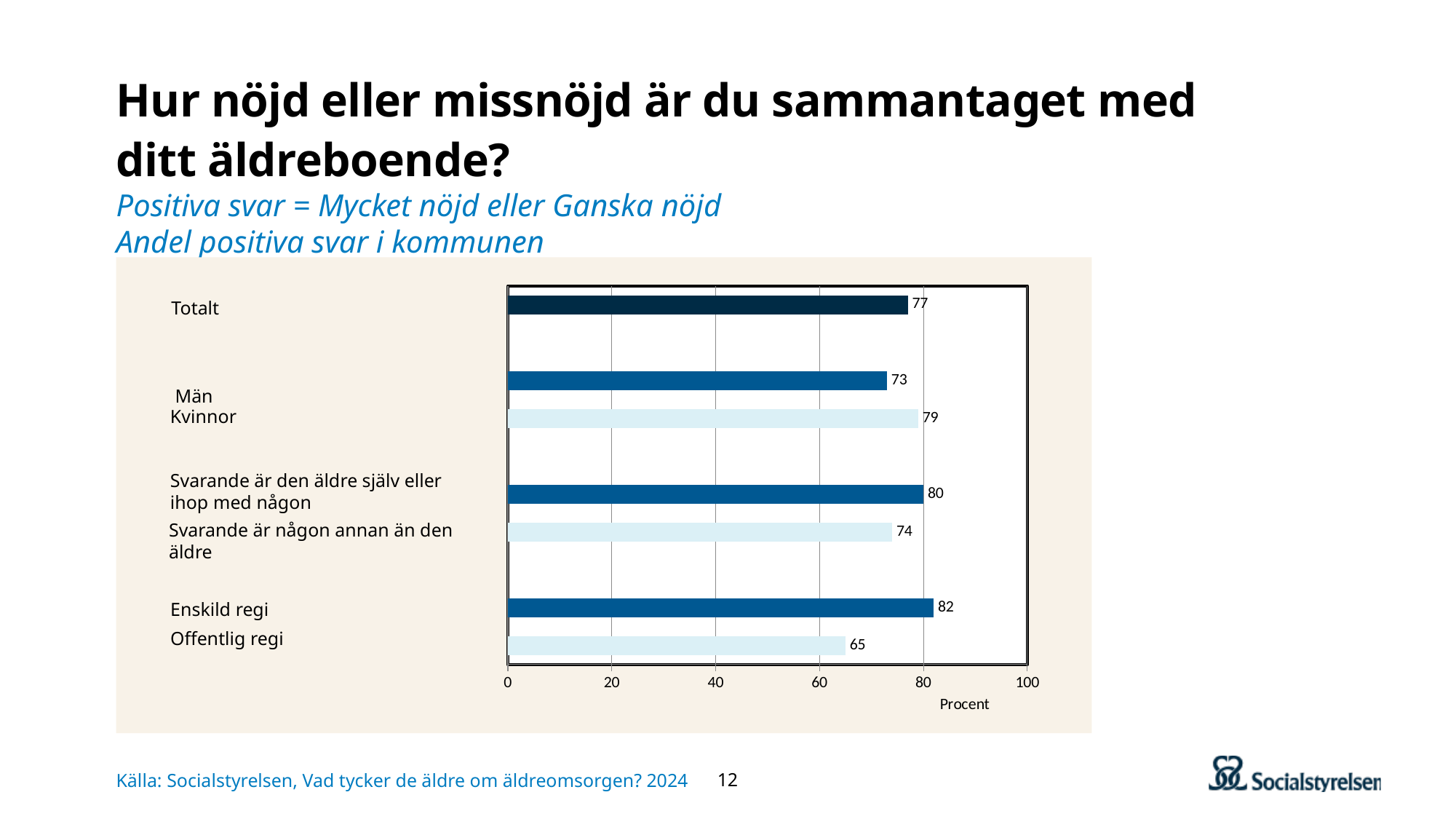
What is the difference between Kvinnor and Män? 6 What is the difference between Enskild regi and Offentlig regi? 17 Which is larger, Svarande är den äldre själv eller ihop med någon or Svarande är någon annan än den äldre? Svarande är den äldre själv eller ihop med någon How many bars are shown in the chart? 7 Which category has the lowest value? Offentlig regi What is the value for Kvinnor? 79 What is the label on the horizontal axis? Procent What is the value for Totalt? 77 What is the value for Offentlig regi? 65 Which category has the highest value? Enskild regi What kind of chart is shown on the slide? Bar chart What is the value for Män? 73